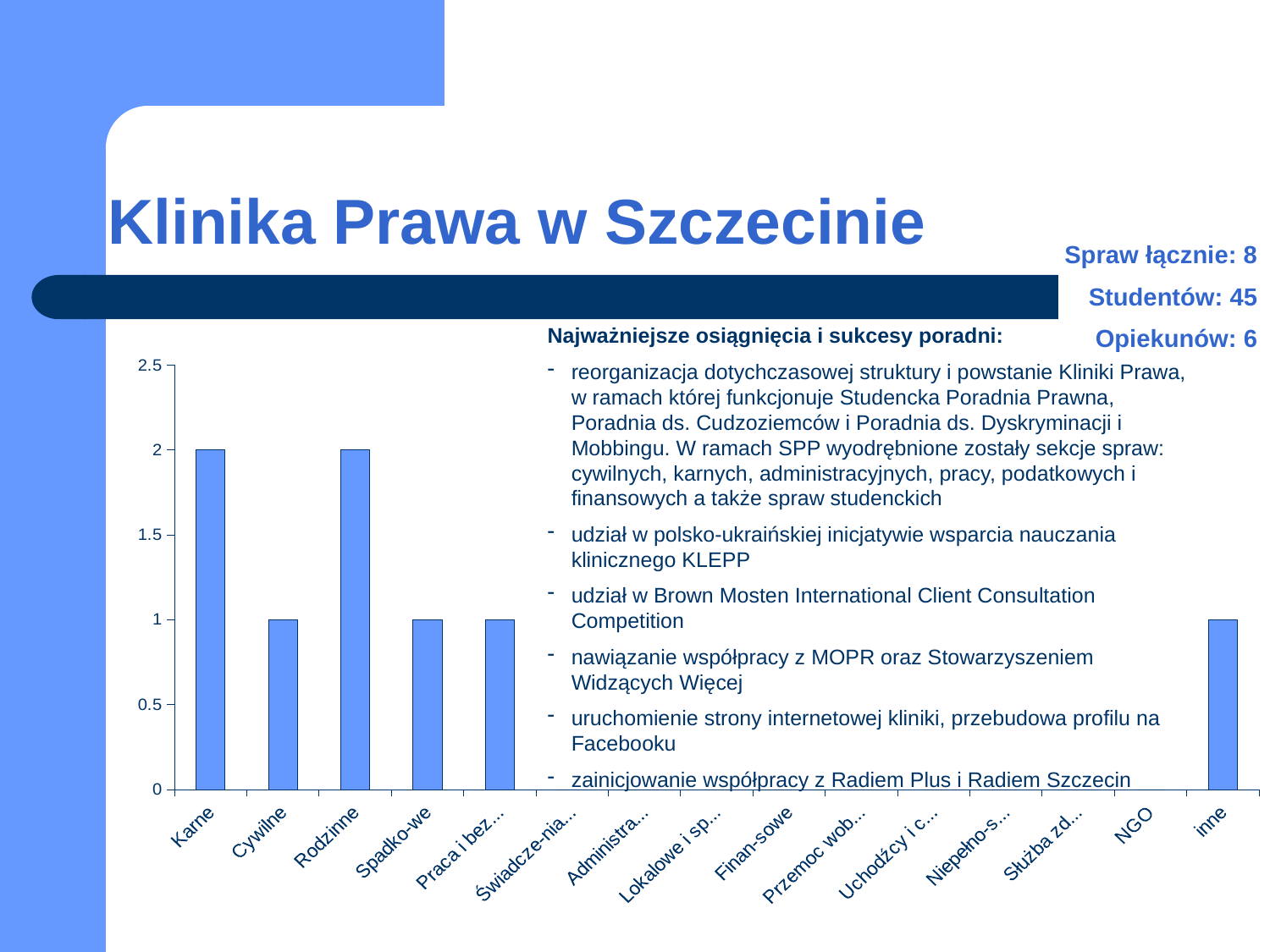
What is the value for Cywilne? 1 What is the difference between the value for Rodzinne and the value for Spadko-we? 1 What is the value for Karne? 2 What is the value for NGO? 0 What is the value for inne? 1 What kind of chart is shown on the slide? bar chart What is the highest value shown on the y axis? 2.5 How many categories are shown on the x axis? 15 Which is larger, the value for Karne or the value for Cywilne? Karne Is the value for Karne greater or less than 1.5? greater What is the value for Rodzinne? 2 What is the title of the slide containing the chart? Klinika Prawa w Szczecinie